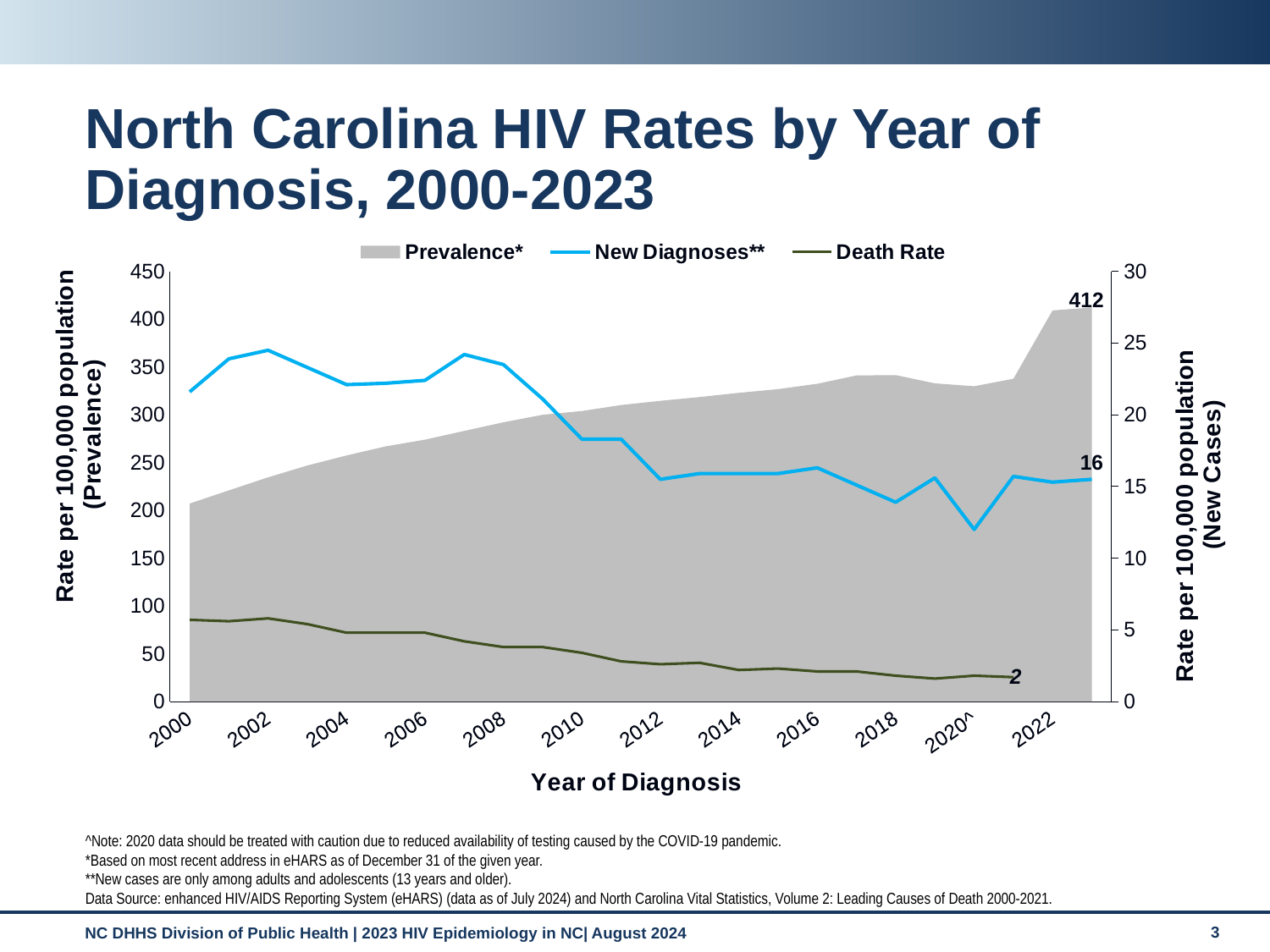
Does the death rate rise or fall across the years shown? fall Which series is drawn as a shaded grey area? Prevalence* What is the labeled new diagnoses rate for 2023? 16 In which year is the prevalence rate highest? 2023 Does the prevalence rate rise or fall from 2000 to 2023? rise What is the last labeled value on the Death Rate line? 2 Is the prevalence rate for 2000 greater or less than 250? less What is the title of the x axis? Year of Diagnosis How many series does the legend list? 3 Is the new diagnoses rate for 2000 greater or less than 20 on the right axis? greater What is the labeled prevalence rate for 2023? 412 In which year is the new diagnoses rate lowest? 2020